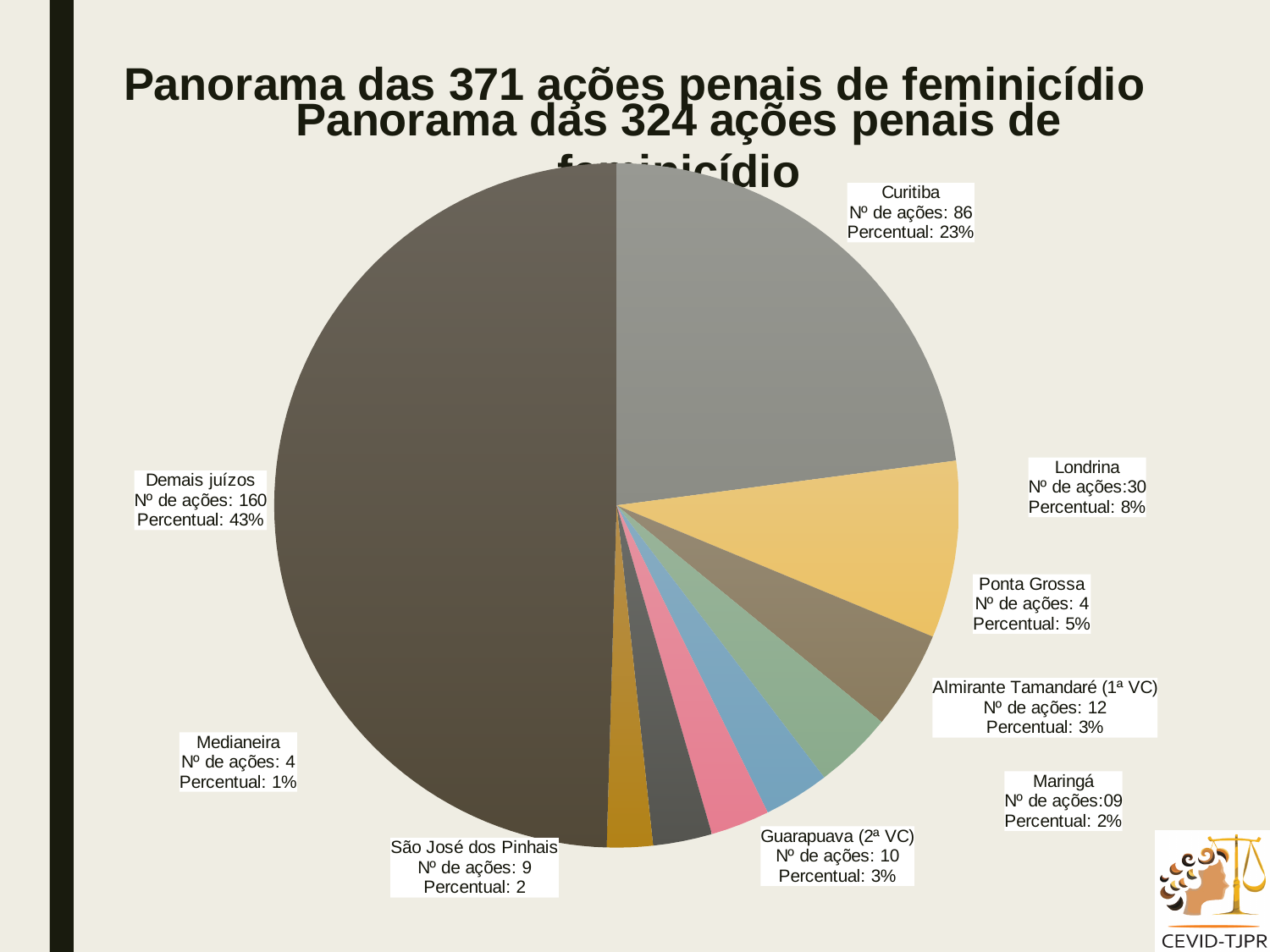
Which category has the largest slice of the pie? Demais juízos What is the Nº de ações for Demais juízos? 160 How many ações (Nº de ações) are shown for Curitiba? 86 What percentual is shown for Medianeira? 1% What share of the pie does Curitiba represent? 23% Which category has the smallest percentual shown on the chart? Medianeira What is the difference in Nº de ações between Curitiba and Londrina? 56 How many slices does the pie chart have? 9 Which has more ações, Guarapuava (2ª VC) or Almirante Tamandaré (1ª VC)? Almirante Tamandaré (1ª VC) What is the Nº de ações for Almirante Tamandaré (1ª VC)? 12 What kind of chart is shown on the slide? pie chart What is the Nº de ações for Londrina? 30